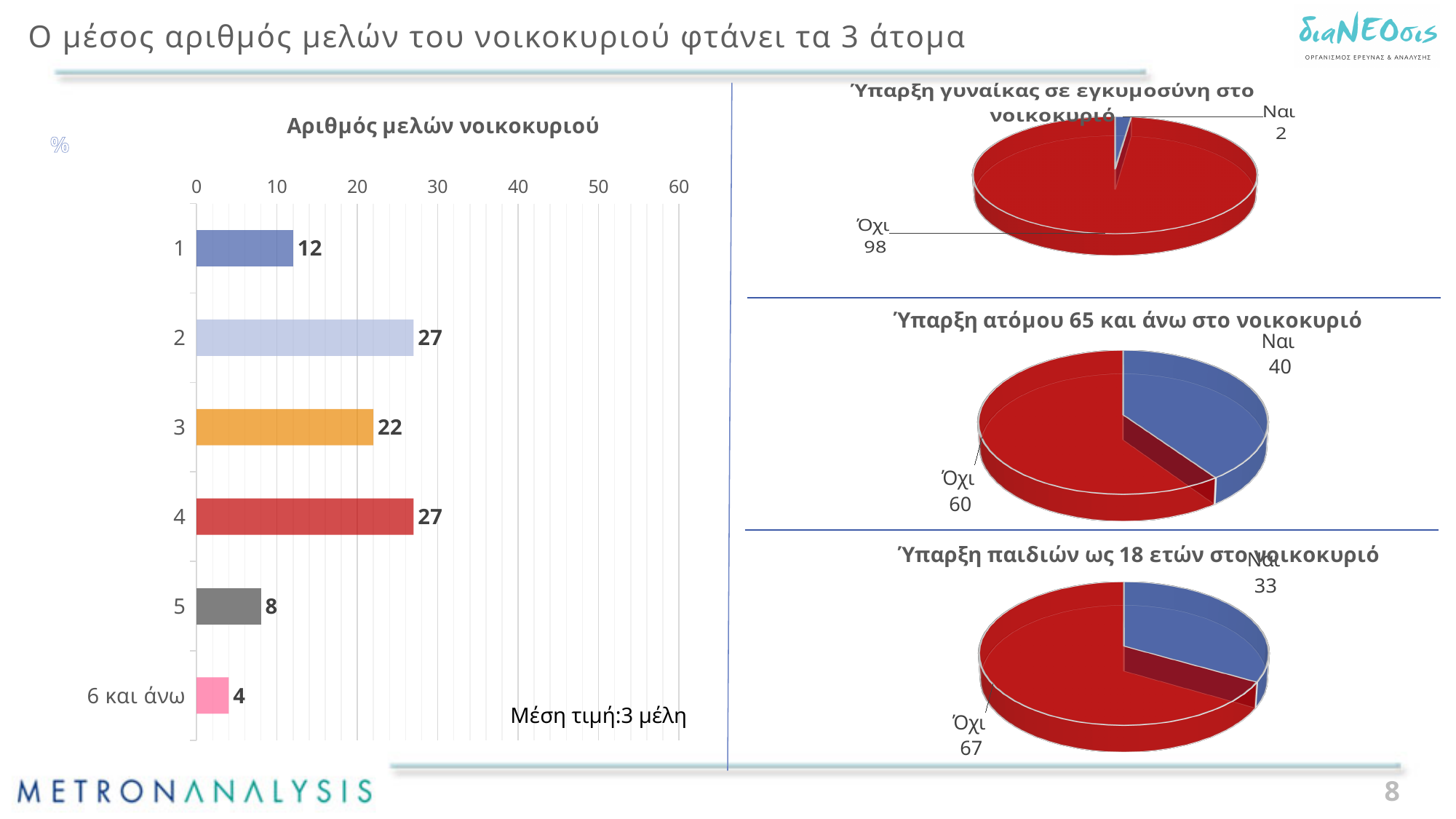
In the chart 'Αριθμός μελών νοικοκυριού', which is larger, the value for category 3 or category 5? 3 What kind of chart is 'Αριθμός μελών νοικοκυριού'? bar chart In the chart 'Αριθμός μελών νοικοκυριού', what is the value for category 3? 22 In the chart 'Αριθμός μελών νοικοκυριού', what is the value for category '6 και άνω'? 4 In the pie chart 'Ύπαρξη παιδιών ως 18 ετών στο νοικοκυριό', what is the difference between 'Όχι' and 'Ναι'? 34 What mean value is stated on the chart 'Αριθμός μελών νοικοκυριού'? 3 μέλη In the pie chart 'Ύπαρξη παιδιών ως 18 ετών στο νοικοκυριό', which slice is larger, 'Ναι' or 'Όχι'? Όχι In the pie chart 'Ύπαρξη γυναίκας σε εγκυμοσύνη στο νοικοκυριό', what is the value for 'Όχι'? 98 In the chart 'Αριθμός μελών νοικοκυριού', what is the difference between the values for category 2 and category 1? 15 In the chart 'Αριθμός μελών νοικοκυριού', which category has the lowest value? 6 και άνω How many categories are shown in the chart 'Αριθμός μελών νοικοκυριού'? 6 In the pie chart 'Ύπαρξη ατόμου 65 και άνω στο νοικοκυριό', what is the value for 'Ναι'? 40